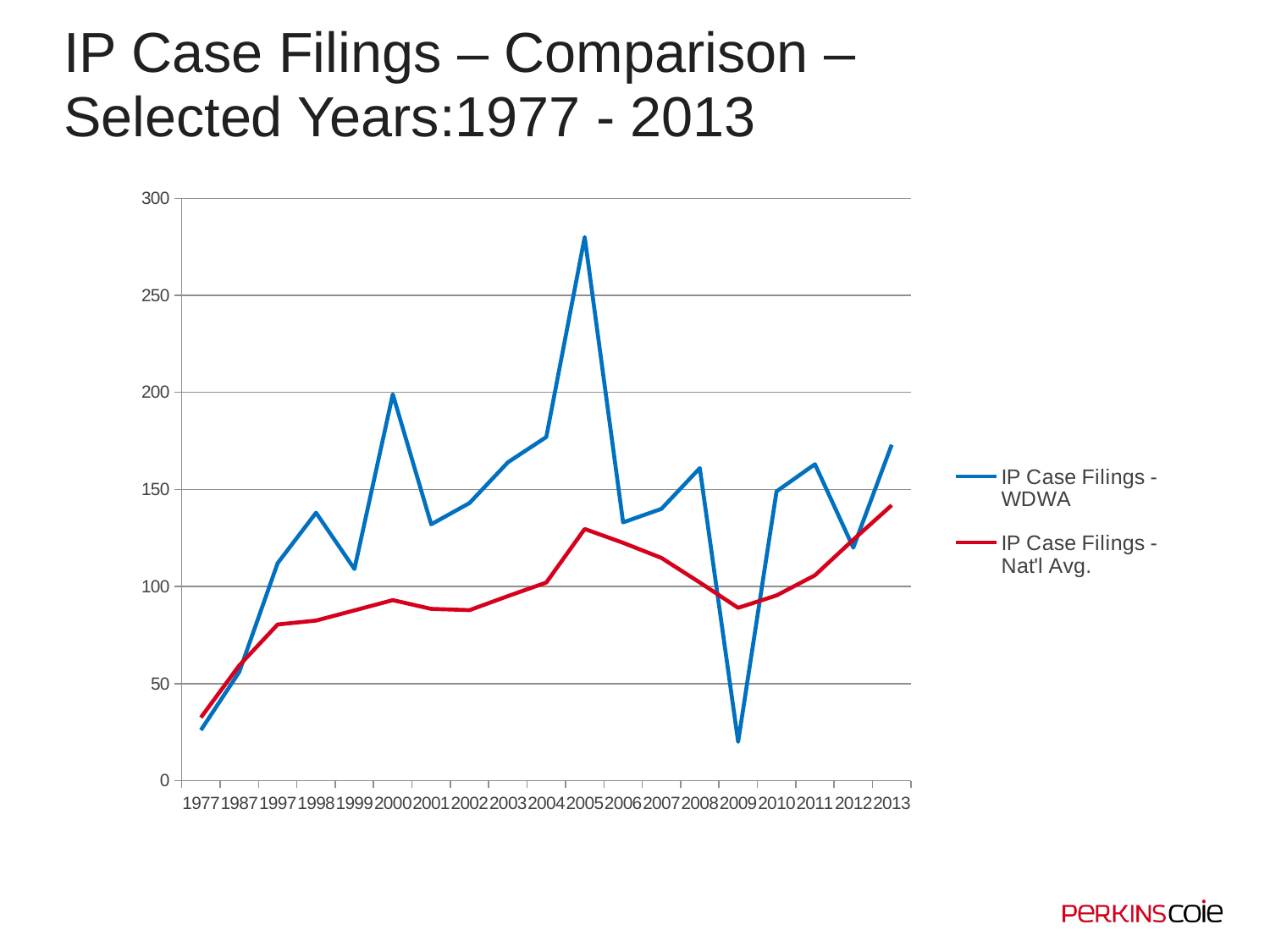
Which colour is used for the IP Case Filings - Nat'l Avg. line? red Is the IP Case Filings - WDWA value for 2009 greater or less than 50? less What kind of chart is shown on the slide? line chart In which year does the IP Case Filings - WDWA series reach its highest value? 2005 Is the IP Case Filings - WDWA value for 2005 greater or less than 250? greater In 2005, which series has the larger value, IP Case Filings - WDWA or IP Case Filings - Nat'l Avg.? IP Case Filings - WDWA How many series does the legend list? 2 In 2009, which series has the larger value, IP Case Filings - WDWA or IP Case Filings - Nat'l Avg.? IP Case Filings - Nat'l Avg. Is the IP Case Filings - Nat'l Avg. value for 2000 greater or less than 100? less In which year is the IP Case Filings - Nat'l Avg. series at its lowest? 1977 How many years are plotted along the x axis? 19